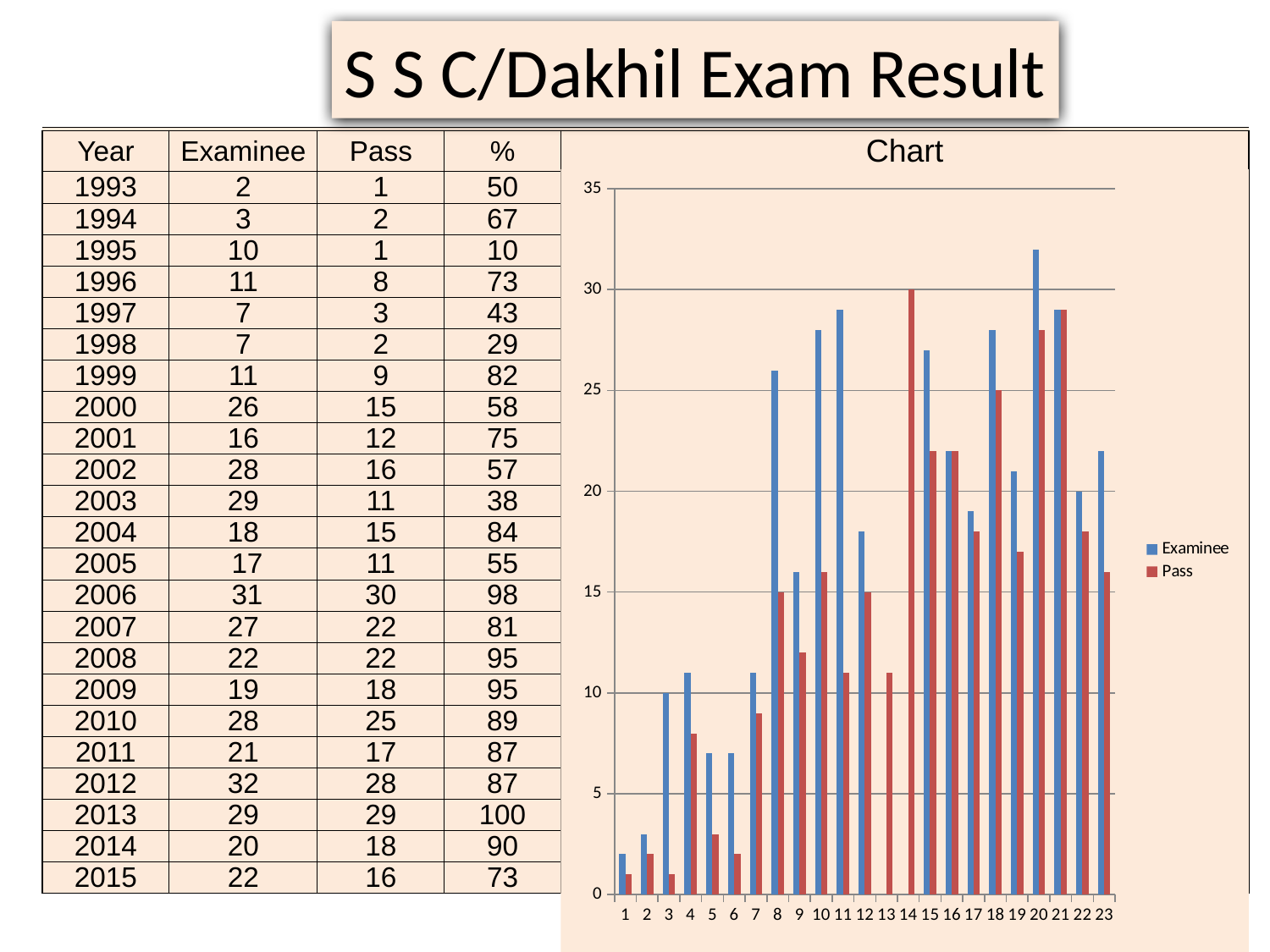
How many categories are shown along the x axis of the chart? 23 Which series is drawn in blue in the chart? Examinee What is the Examinee value for category 22 in the chart? 20 For category 8, which is larger, the Examinee value or the Pass value? Examinee What kind of chart is shown on the slide? bar chart What is the Pass value for category 14 in the chart? 30 Is the Pass value for category 23 greater or less than 20? less Is the Examinee value for category 8 greater or less than 25? greater What is the Examinee value for category 3 in the chart? 10 What is the title of the chart? Chart How many series does the chart legend list? 2 Is the Pass value for category 18 greater or less than 20? greater